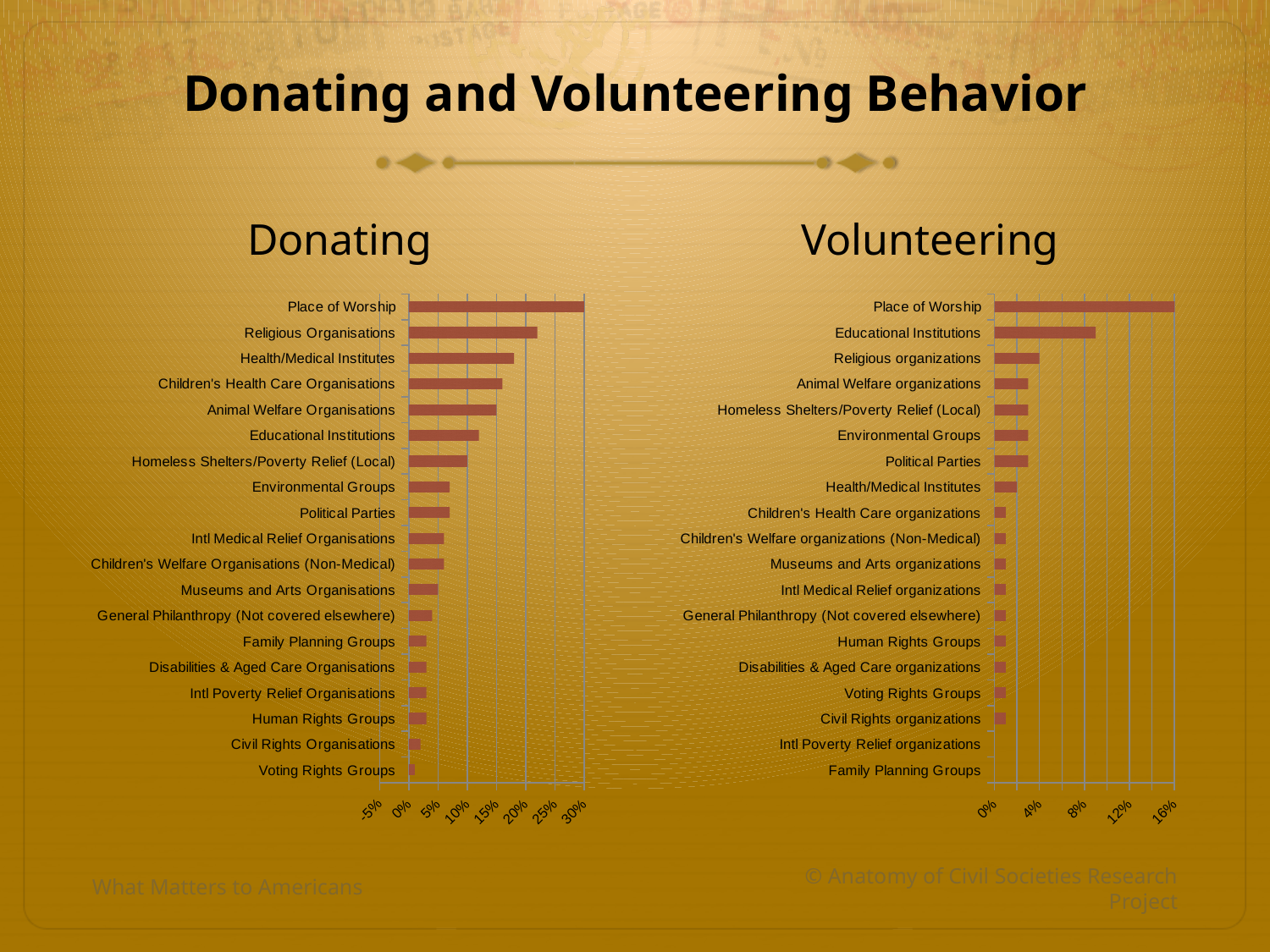
In the Donating chart, which category has the lowest value? Voting Rights Groups In the Donating chart, which category has the highest value? Place of Worship In the Volunteering chart, is the value for Religious organizations greater or less than 8%? less In the Volunteering chart, which category has the highest value? Place of Worship In the Volunteering chart, is the value for Educational Institutions greater or less than 4%? greater What kind of chart is the Donating chart? bar chart In the Donating chart, is the value for Place of Worship greater or less than 25%? greater How many categories are shown in the Volunteering chart? 19 What are the titles of the two charts on the slide? Donating and Volunteering In the Donating chart, which is larger: Religious Organisations or Educational Institutions? Religious Organisations How many categories are shown in the Donating chart? 19